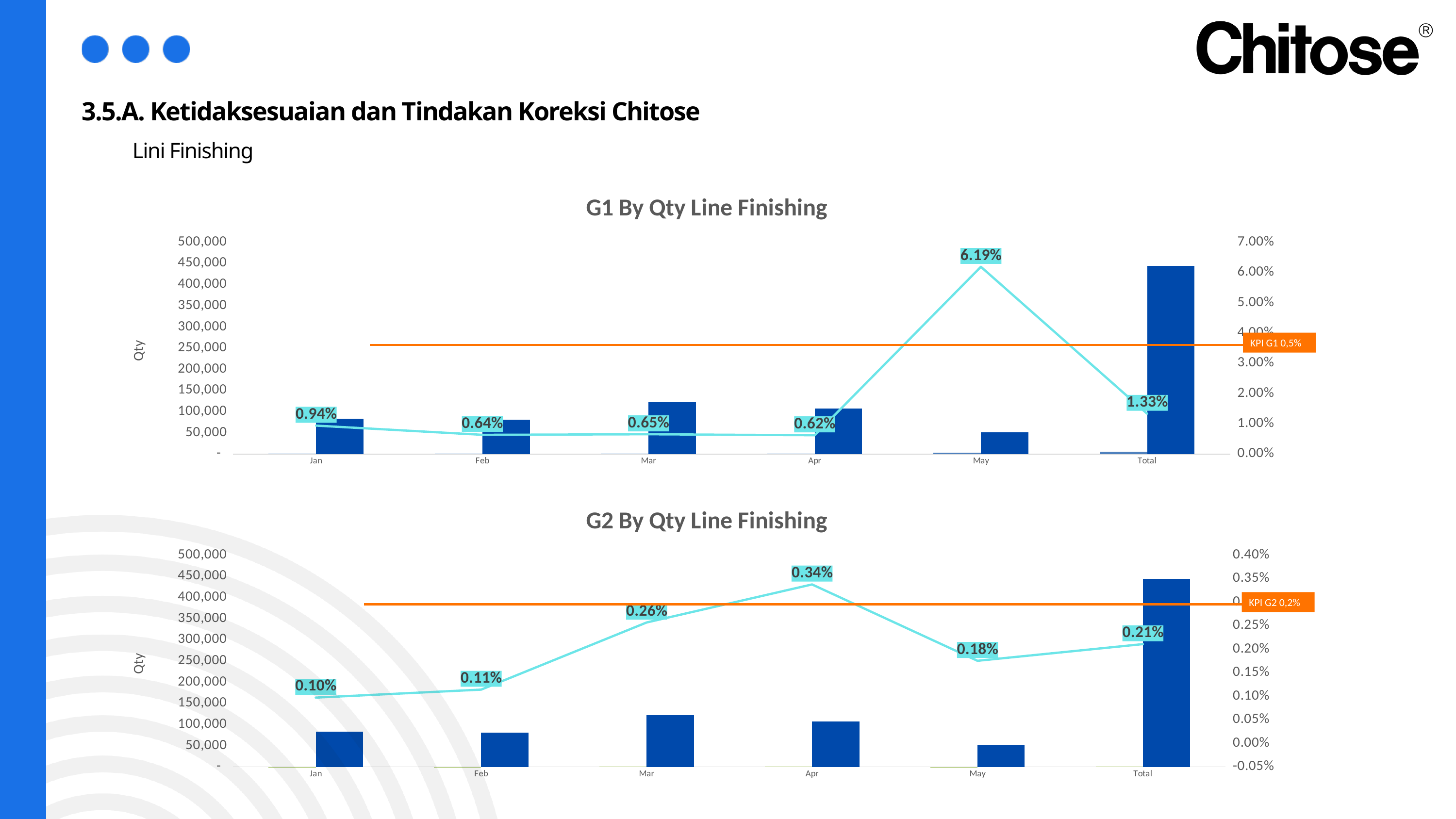
What does the orange reference line in the G2 By Qty Line Finishing chart represent, according to its label? KPI G2 0,2% In the G2 By Qty Line Finishing chart, which is larger, the labelled percentage for Mar or for May? Mar In the G1 By Qty Line Finishing chart, is the Qty bar for Total greater or less than 400,000? greater In the G1 By Qty Line Finishing chart, what is the percentage value labelled for Jan? 0.94% How many categories are shown on the x axis of the G2 By Qty Line Finishing chart? 6 In the G2 By Qty Line Finishing chart, what is the percentage value labelled for Apr? 0.34% In the G2 By Qty Line Finishing chart, what is the difference between the labelled percentages for Apr and Jan? 0.24% In the G1 By Qty Line Finishing chart, is the Qty bar for May greater or less than 100,000? less In the G1 By Qty Line Finishing chart, what is the difference between the labelled percentages for May and Total? 4.86% In the G2 By Qty Line Finishing chart, which month has the lowest labelled percentage? Jan In the G1 By Qty Line Finishing chart, what is the percentage value labelled for May? 6.19% In the G1 By Qty Line Finishing chart, which month has the highest labelled percentage? May